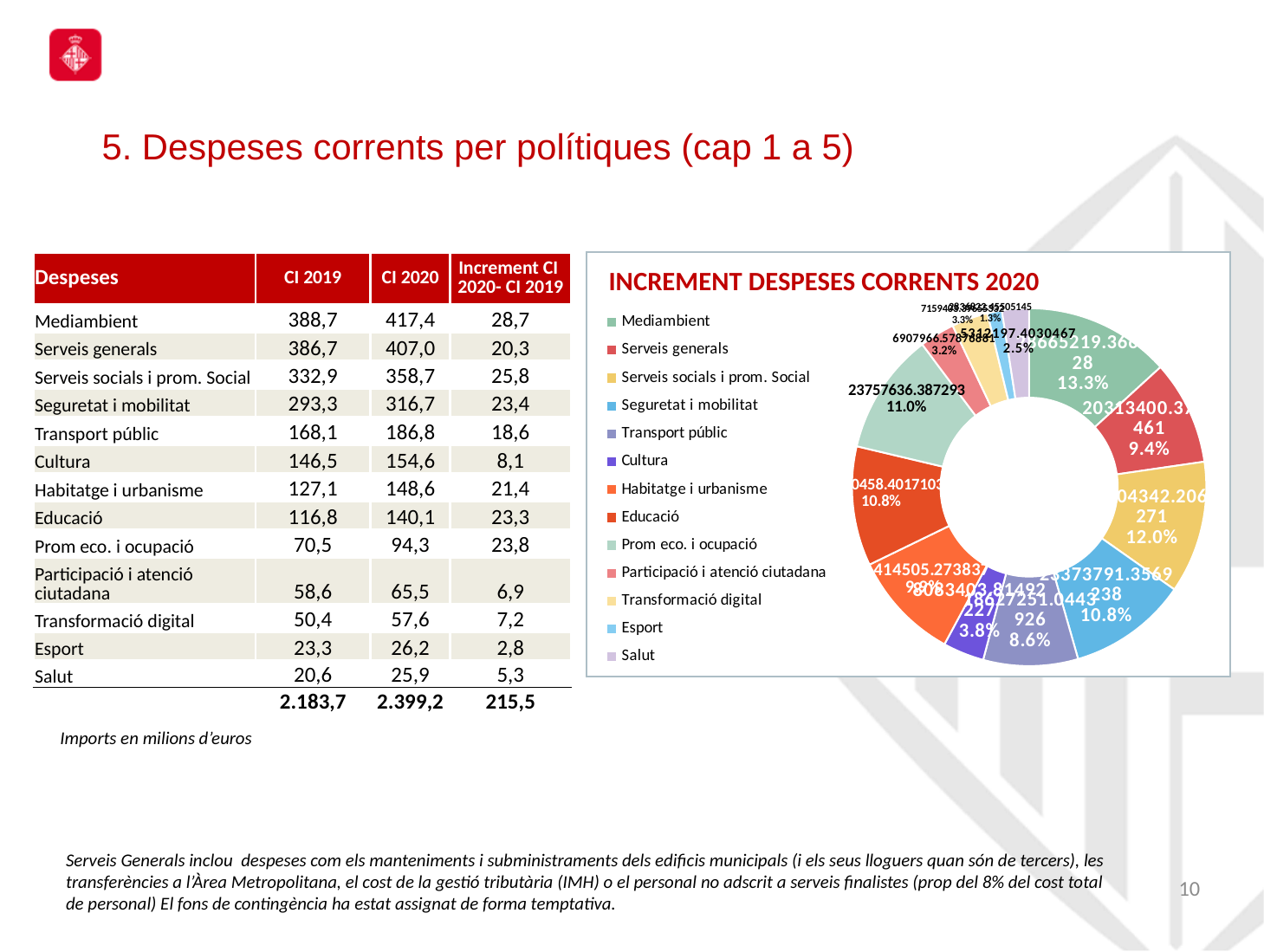
How many slices does the doughnut chart have? 13 What kind of chart is shown on the slide? Doughnut (pie) chart What percentage share does the Serveis socials i prom. Social slice show? 12.0% What percentage share does the Serveis generals slice show? 9.4% Which category has the largest share of the doughnut chart? Mediambient By how many percentage points does the Mediambient share exceed the Serveis generals share? 3.9 percentage points What percentage share does the Transport públic slice show? 8.6% Which category has the smallest share of the doughnut chart? Esport How many entries does the chart's legend list? 13 Which slice is larger, Cultura or Prom eco. i ocupació? Prom eco. i ocupació What percentage share does the Mediambient slice show? 13.3% What is the title of the chart on the slide? INCREMENT DESPESES CORRENTS 2020